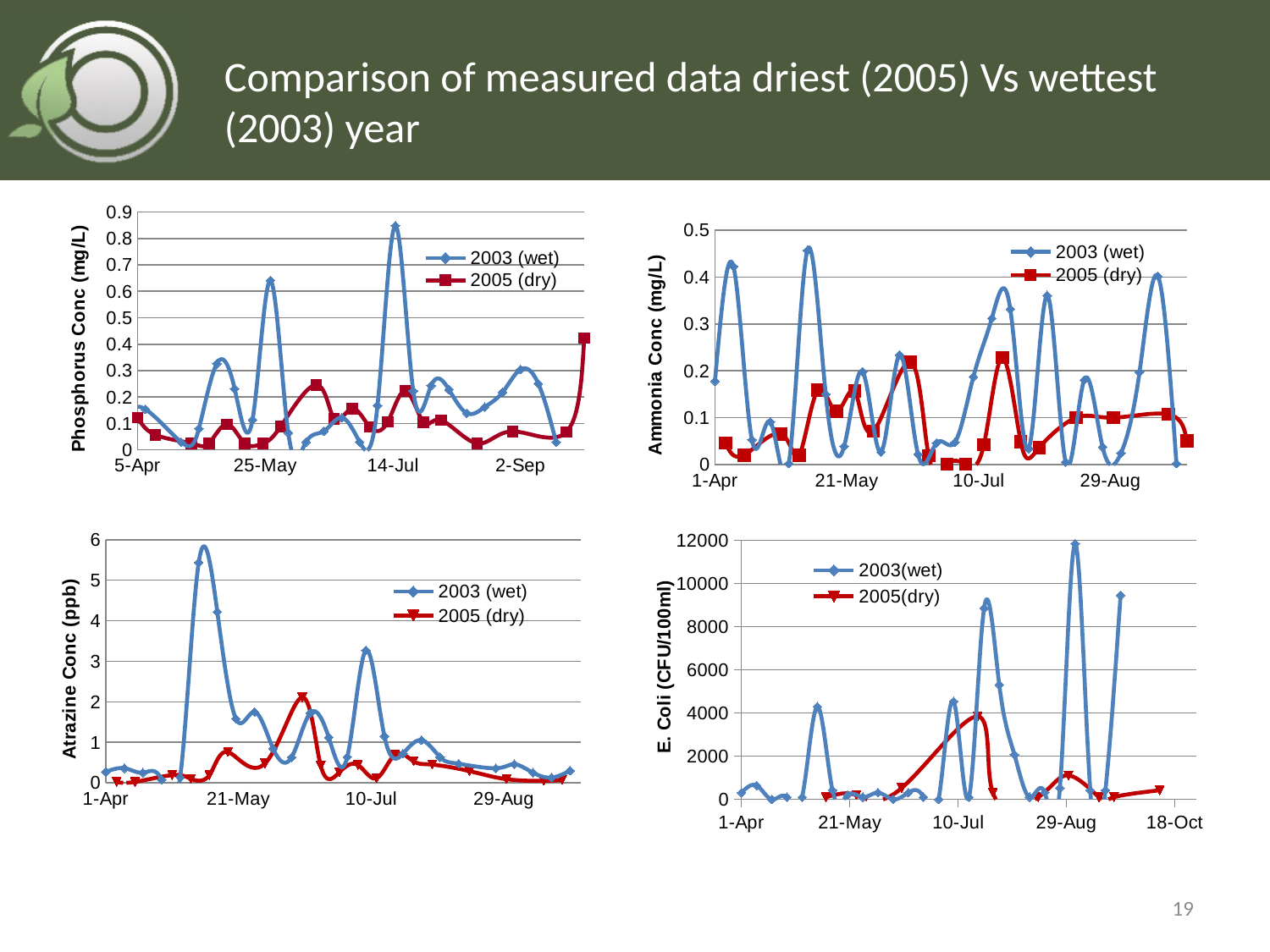
What kind of chart is the Phosphorus Conc (mg/L) chart at the top left of the slide? line chart In the Atrazine Conc (ppb) chart, is the highest value of the 2003 (wet) series greater or less than 5? greater In the Ammonia Conc (mg/L) chart at the top right, is the highest value of the 2005 (dry) series greater or less than 0.3? less How many series does the legend of the Atrazine Conc (ppb) chart list? 2 How many charts are shown on the slide? 4 In the Phosphorus Conc (mg/L) chart, is the highest value of the 2003 (wet) series greater or less than 0.7? greater In the E. Coli (CFU/100ml) chart at the bottom right, what are the two legend entries? 2003(wet) and 2005(dry) In the Atrazine Conc (ppb) chart, which series reaches the higher peak value, 2003 (wet) or 2005 (dry)? 2003 (wet) What is the y-axis label of the chart at the bottom right of the slide? E. Coli (CFU/100ml)